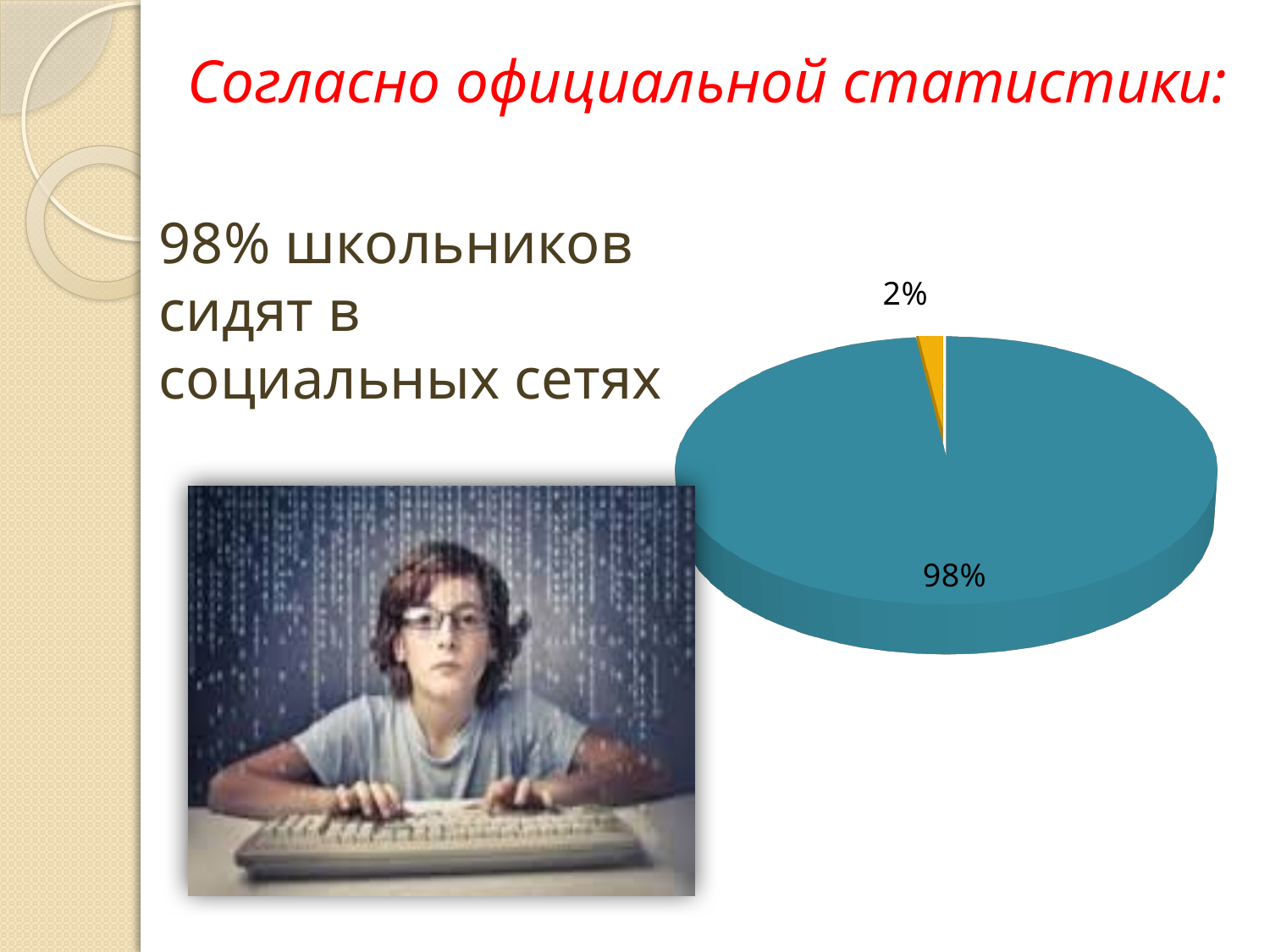
What share of the pie does the teal slice represent? 98% What is the difference in percentage points between the two slices of the pie chart? 96 What is the value of the largest slice of the pie chart? 98% Which slice of the pie chart is larger, the teal one or the orange one? the teal one Is the value of the teal slice greater or less than 50%? greater What colour is the slice labelled 2% in the pie chart? orange What value is labelled on the teal slice of the pie chart? 98% How many slices does the pie chart have? 2 What kind of chart is shown on the slide? pie chart What value is labelled on the orange slice of the pie chart? 2% What is the value of the smallest slice of the pie chart? 2% Is the value of the orange slice greater or less than 10%? less